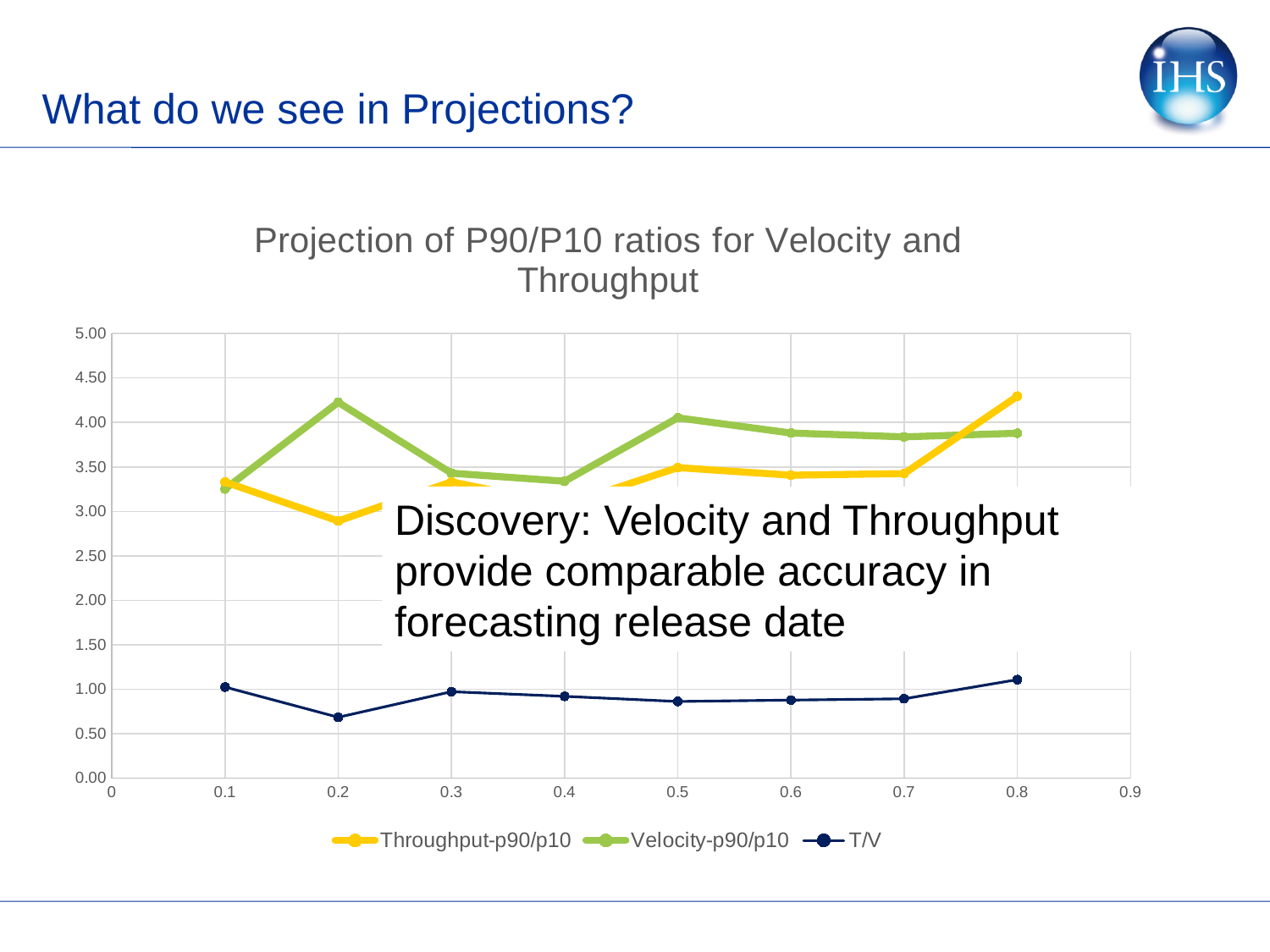
At which x value does the Throughput-p90/p10 series reach its highest value? 0.8 Does the T/V series rise or fall between x = 0.1 and x = 0.2? fall What is the title of the chart? Projection of P90/P10 ratios for Velocity and Throughput At which x value does the T/V series reach its lowest value? 0.2 What kind of chart is shown on the slide? line chart At x = 0.8, which series has the larger value, Throughput-p90/p10 or Velocity-p90/p10? Throughput-p90/p10 Is the value of Velocity-p90/p10 at x = 0.2 greater or less than 4.00? greater Is the value of Throughput-p90/p10 at x = 0.2 greater or less than 3.00? less How many series does the legend list? 3 At which x value does the Throughput-p90/p10 series reach its lowest value? 0.2 Which series is drawn in dark blue in the legend? T/V